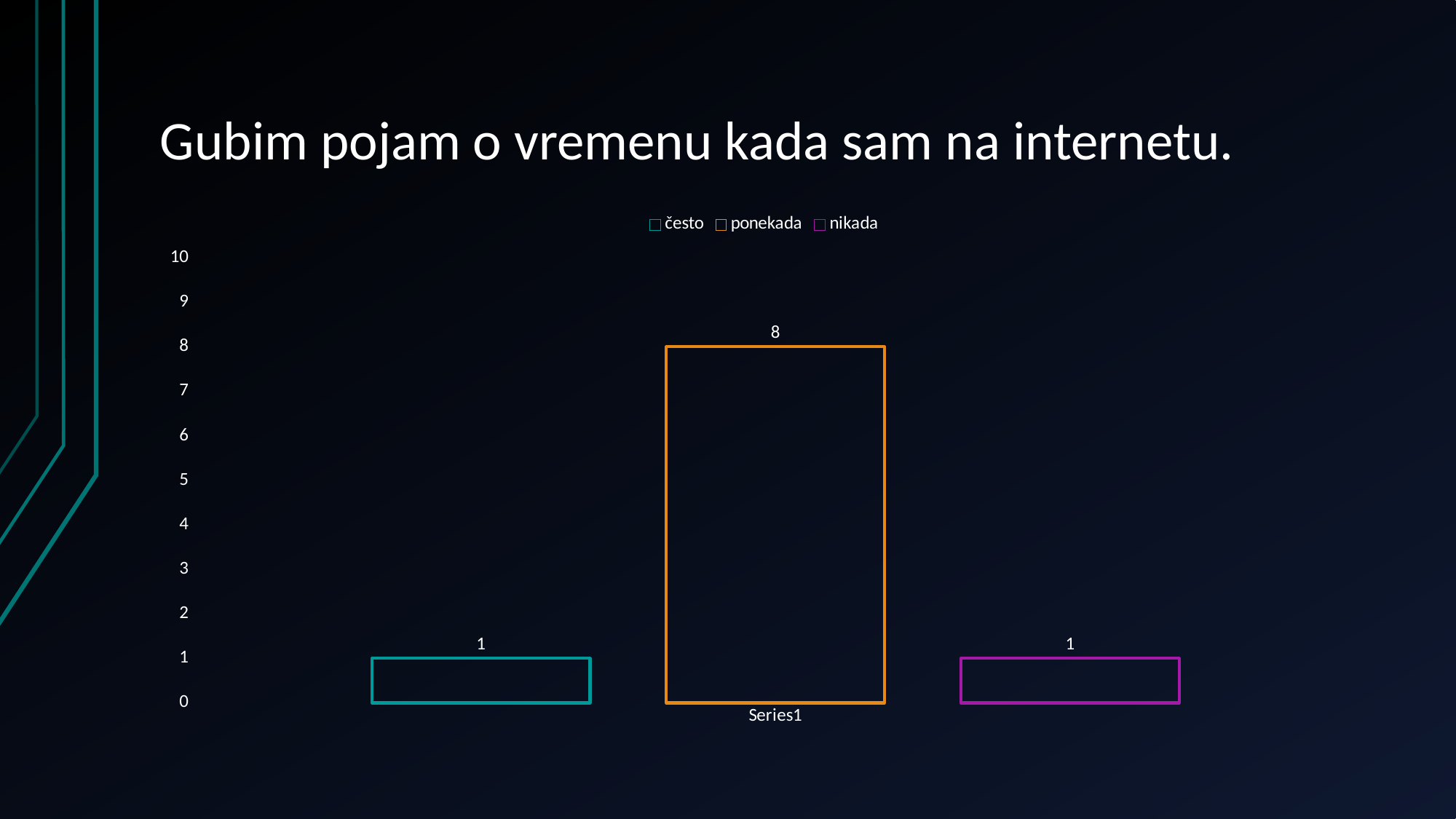
How many series does the legend list? 3 Which is larger, the value for "ponekada" or the value for "nikada"? ponekada What is the total of the three bars shown? 10 What is the title of the chart? Gubim pojam o vremenu kada sam na internetu. What kind of chart is shown on the slide? bar chart What is the difference between the values for "ponekada" and "često"? 7 Is the value for "ponekada" greater or less than 5? greater What is the value for "ponekada"? 8 Which series has the highest value? ponekada Is the value for "često" greater or less than 5? less What is the value for "često"? 1 What is the value for "nikada"? 1